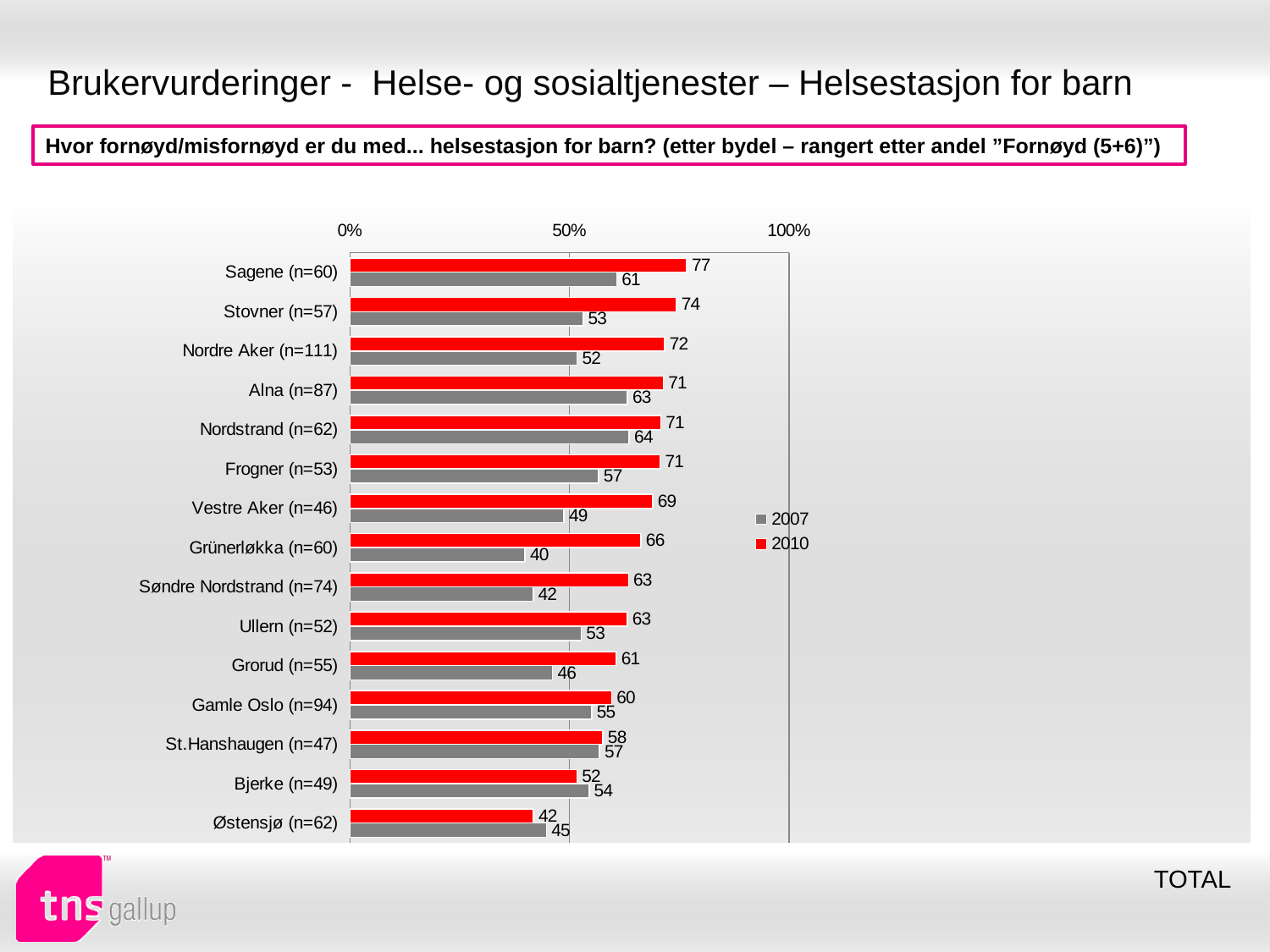
What is the 2007 value for Grünerløkka (n=60)? 40 What kind of chart is shown on the slide? bar chart How many districts are shown on the chart? 15 What is the difference between the 2010 values for Sagene (n=60) and Østensjø (n=62)? 35 Which district has the highest 2010 value? Sagene (n=60) What is the 2010 value for Sagene (n=60)? 77 Which is larger for Bjerke (n=49): the 2007 value or the 2010 value? 2007 How many series does the legend list? 2 What is the difference between the 2010 and 2007 values for Grünerløkka (n=60)? 26 Which colour represents the 2010 series in the legend? red What is the 2007 value for Vestre Aker (n=46)? 49 Which district has the lowest 2010 value? Østensjø (n=62)